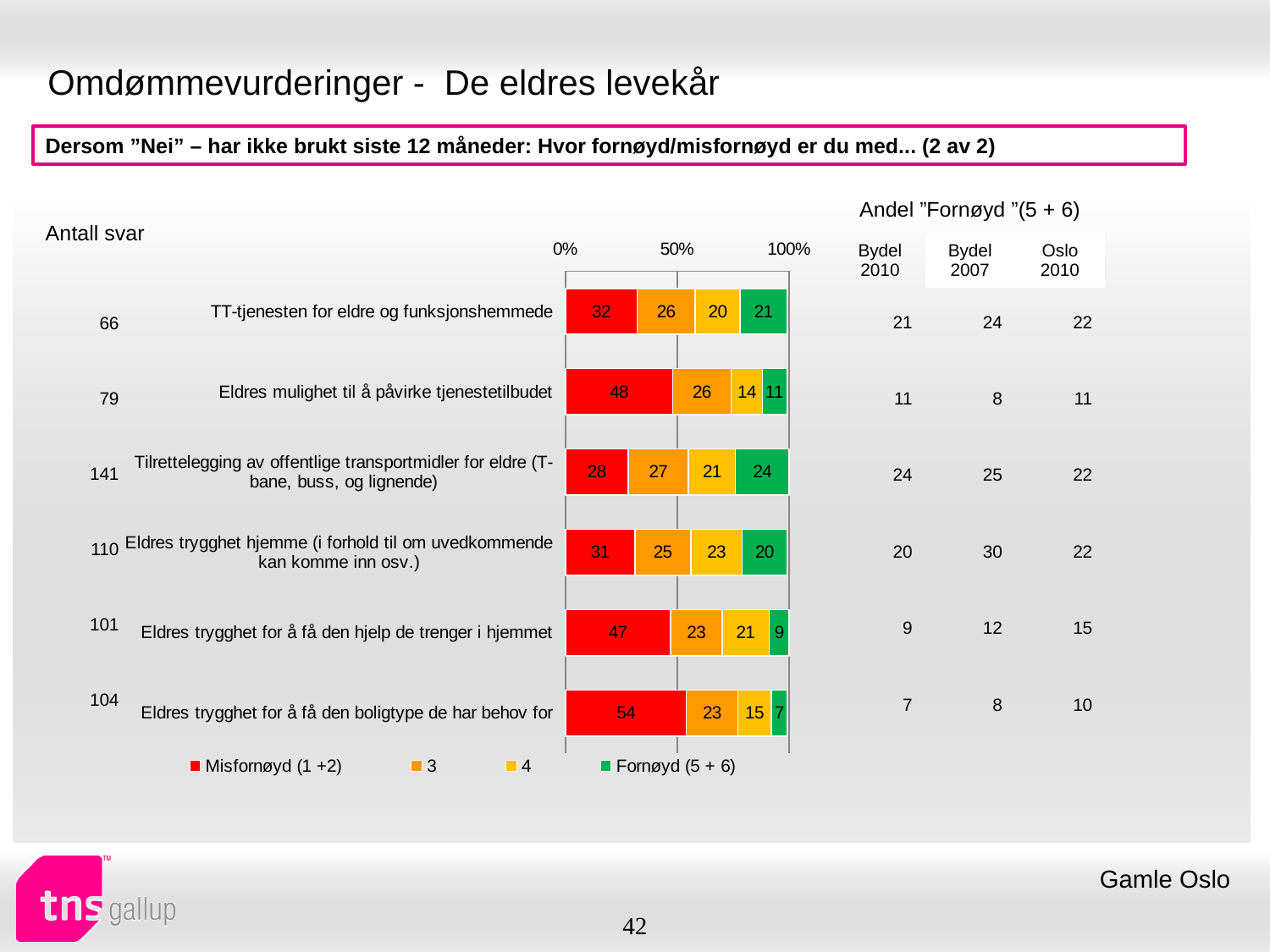
Which is larger: the Fornøyd (5 + 6) value for "TT-tjenesten for eldre og funksjonshemmede" or for "Eldres trygghet for å få den hjelp de trenger i hjemmet"? TT-tjenesten for eldre og funksjonshemmede What is the Fornøyd (5 + 6) value for "Tilrettelegging av offentlige transportmidler for eldre (T-bane, buss, og lignende)"? 24 Which colour represents Fornøyd (5 + 6) in the chart? Green Which category has the lowest Fornøyd (5 + 6) value? Eldres trygghet for å få den boligtype de har behov for What is the Misfornøyd (1 +2) value for "Eldres trygghet for å få den boligtype de har behov for"? 54 How many series does the legend list? 4 What is the total of the stacked bar for "Tilrettelegging av offentlige transportmidler for eldre (T-bane, buss, og lignende)"? 100 Which category has the highest Misfornøyd (1 +2) value? Eldres trygghet for å få den boligtype de har behov for How many categories are shown in the chart? 6 What is the difference between the Misfornøyd (1 +2) values for "Eldres mulighet til å påvirke tjenestetilbudet" and "TT-tjenesten for eldre og funksjonshemmede"? 16 What is the value of series "3" for "TT-tjenesten for eldre og funksjonshemmede"? 26 What kind of chart is shown on the slide? Stacked bar chart